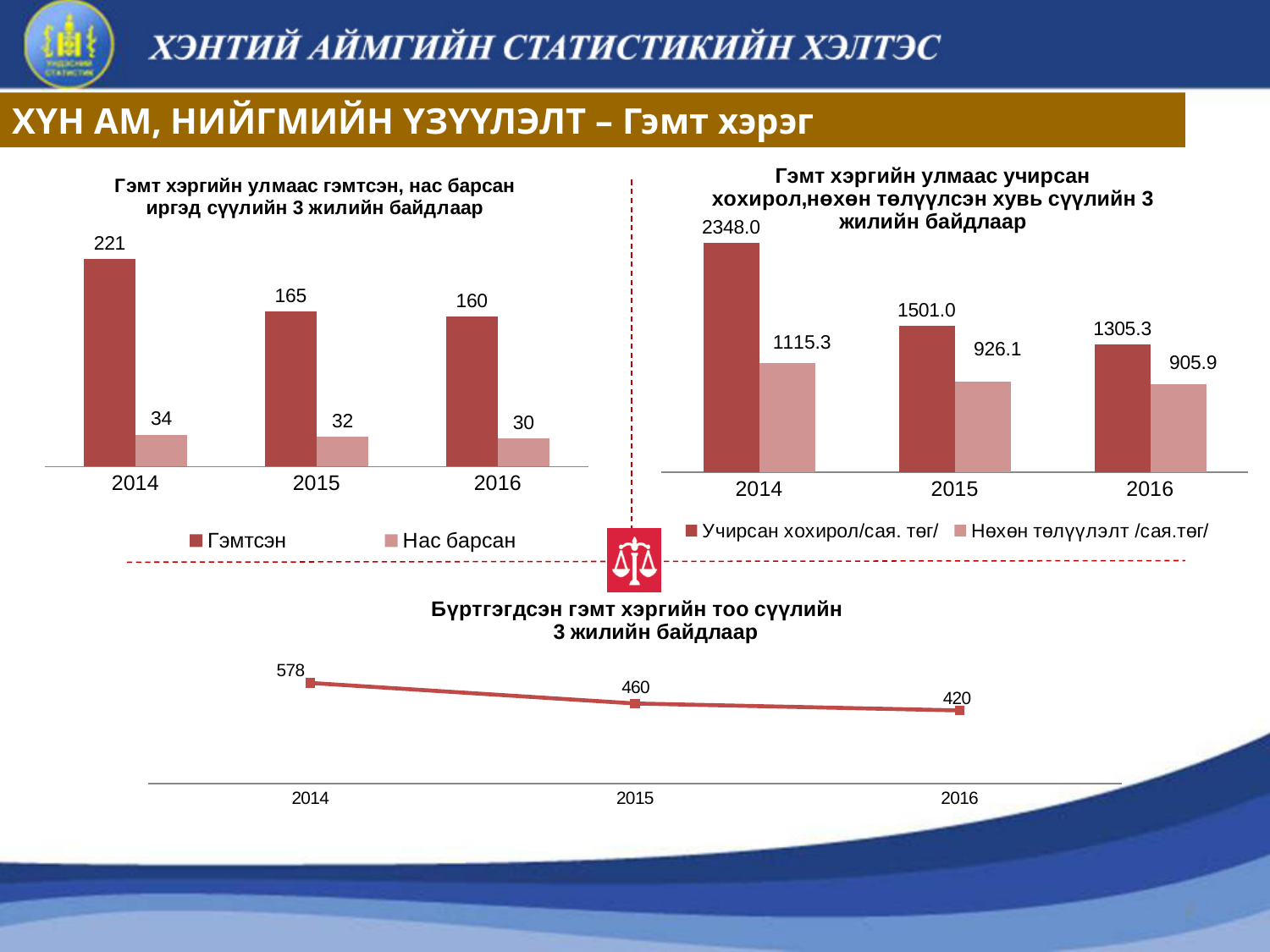
In the top-left chart, which year has the highest Гэмтсэн value? 2014 In the top-left chart, how many series does the legend list? 2 In the top-left chart (Гэмт хэргийн улмаас гэмтсэн, нас барсан иргэд), what is the value for Гэмтсэн in 2014? 221 In the top-left chart, what is the value for Нас барсан in 2016? 30 In the top-right chart, which year has the lowest Нөхөн төлүүлэлт value? 2016 What kind of chart is the bottom chart (Бүртгэгдсэн гэмт хэргийн тоо)? line chart In the top-left chart, what is the difference between the Гэмтсэн values for 2014 and 2015? 56 In the top-right chart, does the Учирсан хохирол value rise or fall from 2014 to 2016? fall In the bottom chart, what is the difference between the values for 2014 and 2016? 158 In the top-right chart, what is the value for Нөхөн төлүүлэлт in 2015? 926.1 In the bottom chart (Бүртгэгдсэн гэмт хэргийн тоо), what is the value for 2015? 460 In the top-right chart (Гэмт хэргийн улмаас учирсан хохирол), what is the value for Учирсан хохирол in 2014? 2348.0